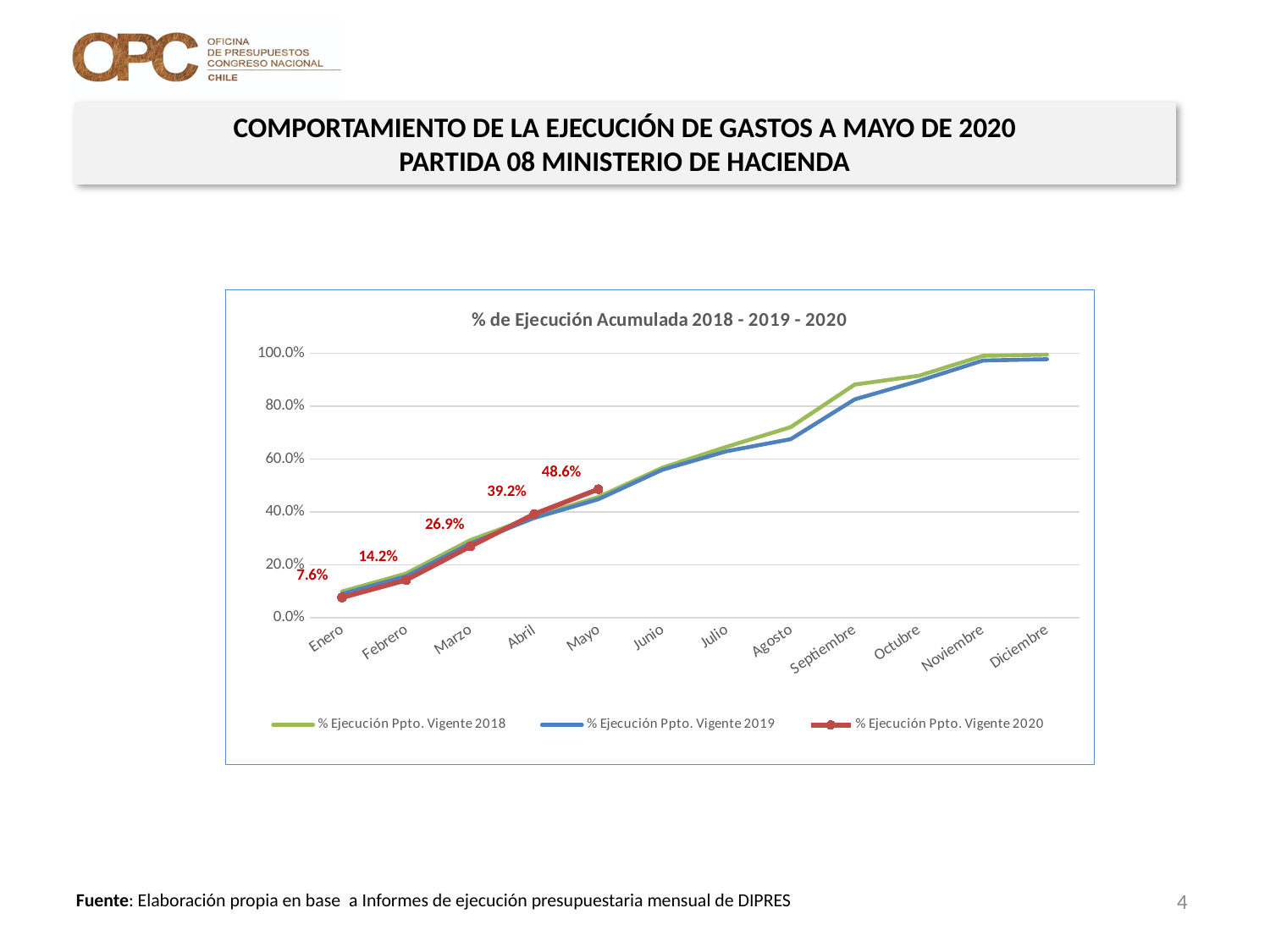
What is the difference between the 2020 values for Febrero and Enero? 6.6 percentage points Is the value for % Ejecución Ppto. Vigente 2018 in Septiembre greater or less than 80.0%? greater What is the difference between the 2020 values for Mayo and Abril? 9.4 percentage points Which month has the lowest labelled value for % Ejecución Ppto. Vigente 2020? Enero What is the value of % Ejecución Ppto. Vigente 2020 for Enero? 7.6% Which is larger for the 2020 series: the value for Abril or the value for Marzo? Abril Which month has the highest labelled value for % Ejecución Ppto. Vigente 2020? Mayo What is the value of % Ejecución Ppto. Vigente 2020 for Marzo? 26.9% How many months are shown on the x axis? 12 How many series does the legend list? 3 What is the value of % Ejecución Ppto. Vigente 2020 for Mayo? 48.6% What kind of chart is shown? Line chart